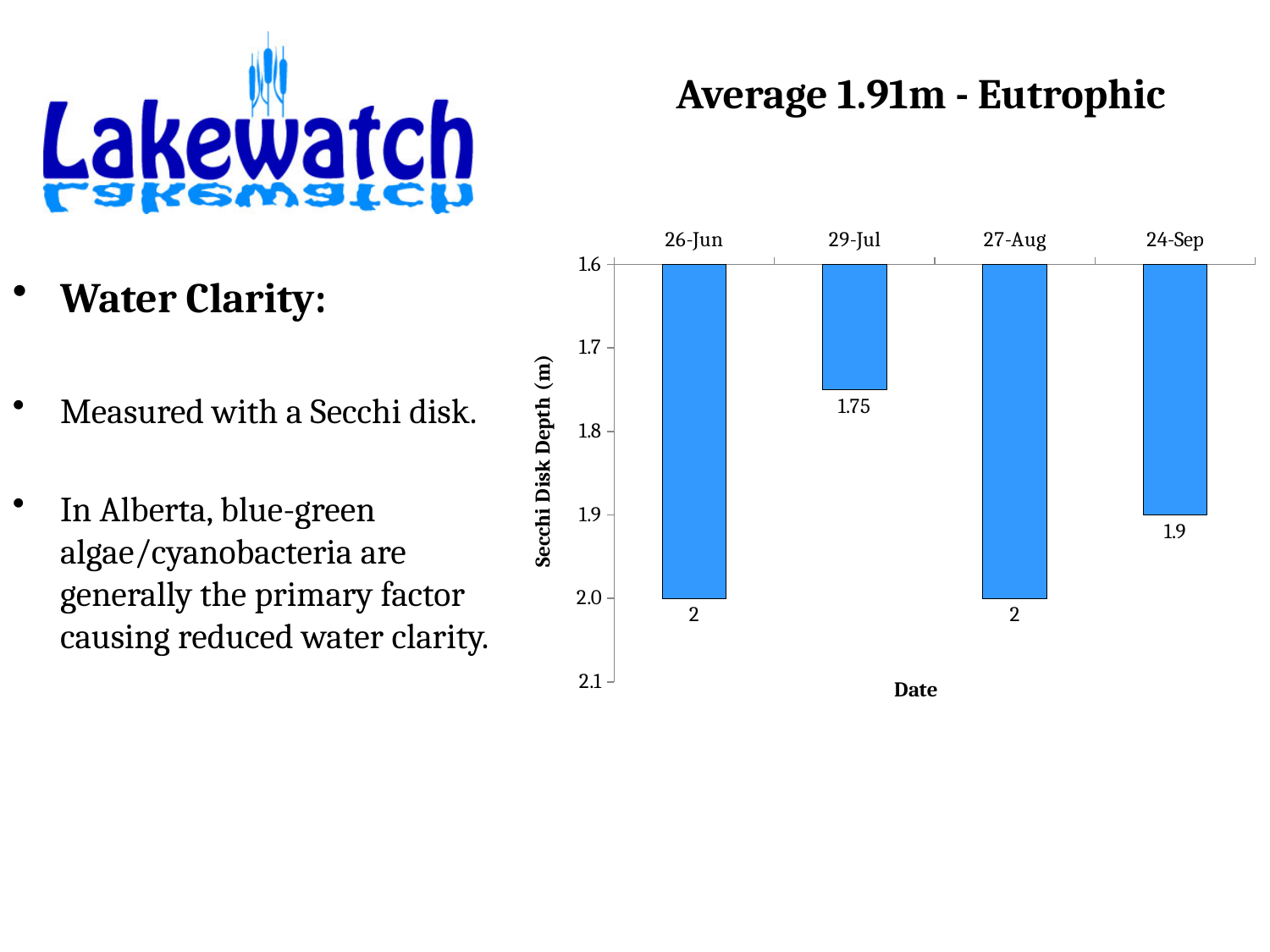
What is the Secchi disk depth for 24-Sep? 1.9 What is the title of the chart? Average 1.91m - Eutrophic Which date has the lowest Secchi disk depth value? 29-Jul Which has the larger Secchi disk depth value, 29-Jul or 24-Sep? 24-Sep How many dates are plotted on the chart? 4 What is the difference between the Secchi disk depth on 26-Jun and on 29-Jul? 0.25 What is the Secchi disk depth for 27-Aug? 2 What kind of chart is shown on the slide? Bar chart What is the difference between the Secchi disk depth on 24-Sep and on 29-Jul? 0.15 What is the Secchi disk depth for 26-Jun? 2 What is the Secchi disk depth for 29-Jul? 1.75 Is the value for 29-Jul greater or less than 1.8? less